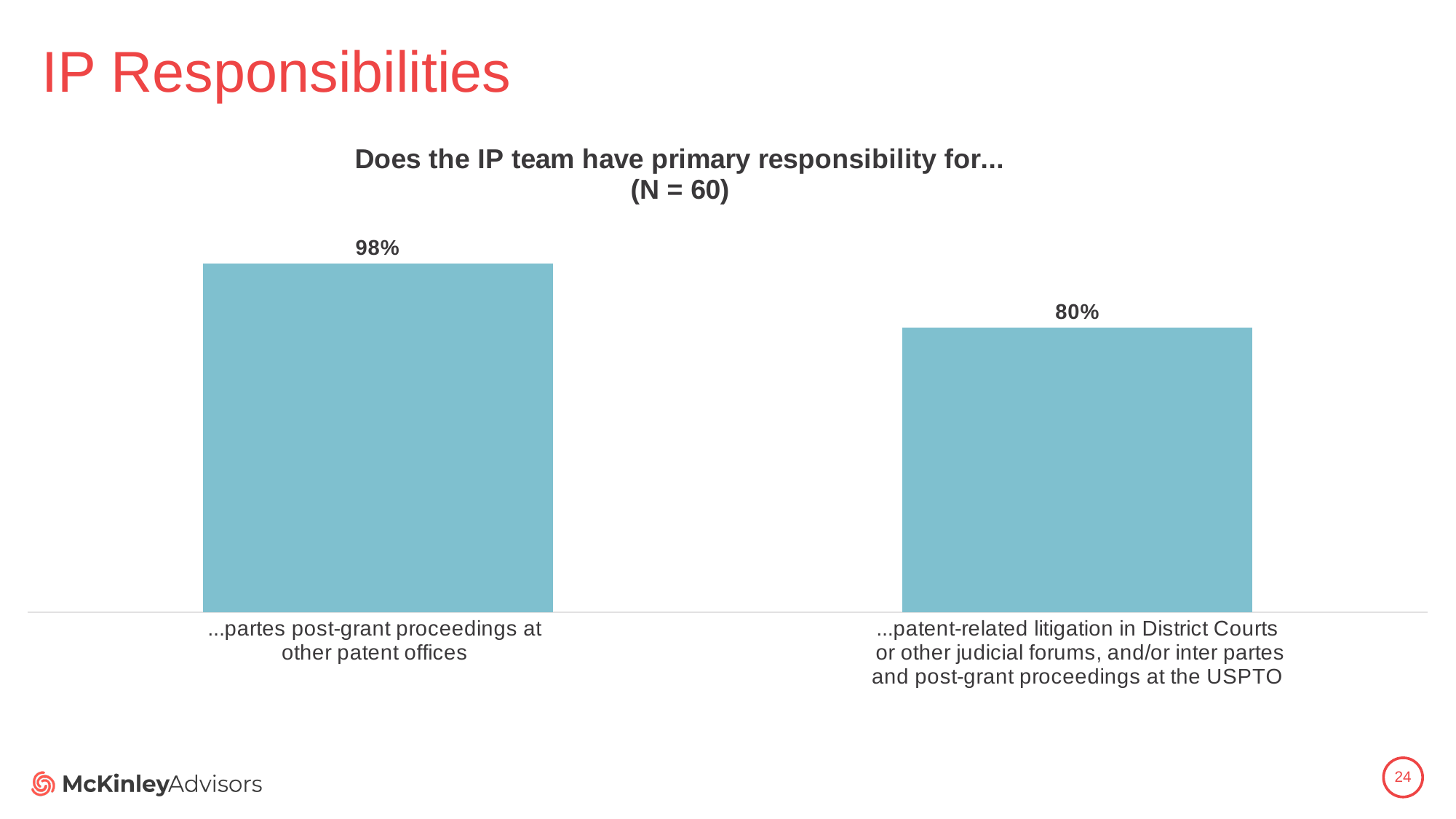
What percentage of respondents said the IP team has primary responsibility for patent-related litigation in District Courts or other judicial forums, and/or inter partes and post-grant proceedings at the USPTO? 80% Which category has the lower value? ...patent-related litigation in District Courts or other judicial forums, and/or inter partes and post-grant proceedings at the USPTO What percentage of respondents said the IP team has primary responsibility for partes post-grant proceedings at other patent offices? 98% What kind of chart is shown on the slide? bar chart What is the difference in percentage points between the two bars? 18 percentage points Is the value for partes post-grant proceedings at other patent offices larger or smaller than the value for patent-related litigation in District Courts and/or proceedings at the USPTO? larger What is the title of the chart? Does the IP team have primary responsibility for... (N = 60) What is the sample size (N) stated in the chart title? 60 Which category has the higher value? ...partes post-grant proceedings at other patent offices How many categories are shown in the chart? 2